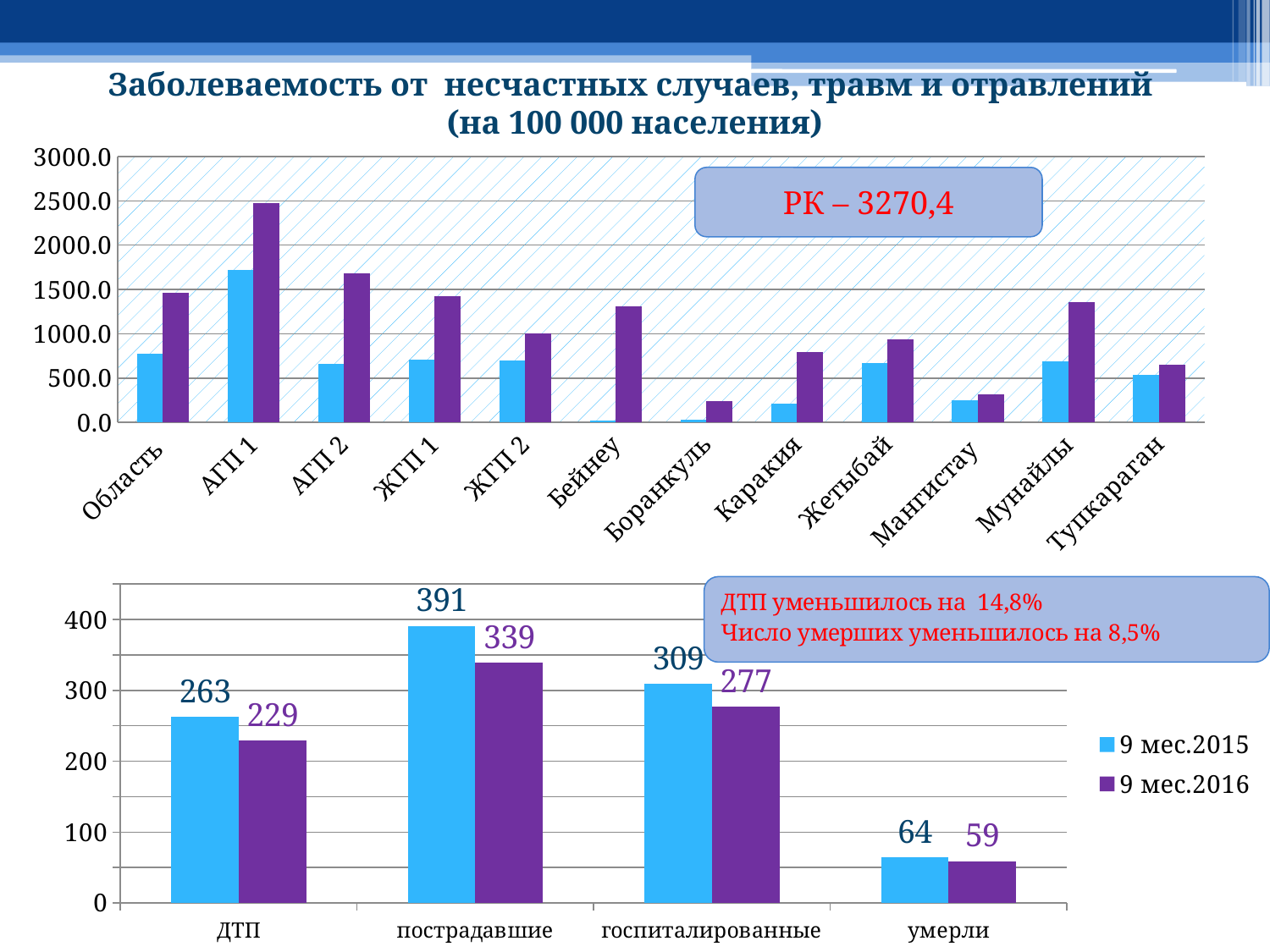
In the top chart, which category has the highest purple bar? АГП 1 In the top chart, is the purple bar for АГП 1 greater or less than 2000.0? greater In the bottom chart, what is the difference between the 9 мес.2015 and 9 мес.2016 values for умерли? 5 In the bottom chart, which category has the highest value in the 9 мес.2015 series? пострадавшие In the bottom chart, what is the value for пострадавшие in the 9 мес.2016 series? 339 In the bottom chart, what is the value for госпитализированные in the 9 мес.2015 series? 309 In the bottom chart, what is the value for ДТП in the 9 мес.2015 series? 263 In the bottom chart, which category has the lowest value in the 9 мес.2016 series? умерли In the top chart, how many categories are shown on the x axis? 12 In the bottom chart, how many categories are shown on the x axis? 4 What kind of chart is the top chart? bar chart In the bottom chart, how many series does the legend list? 2